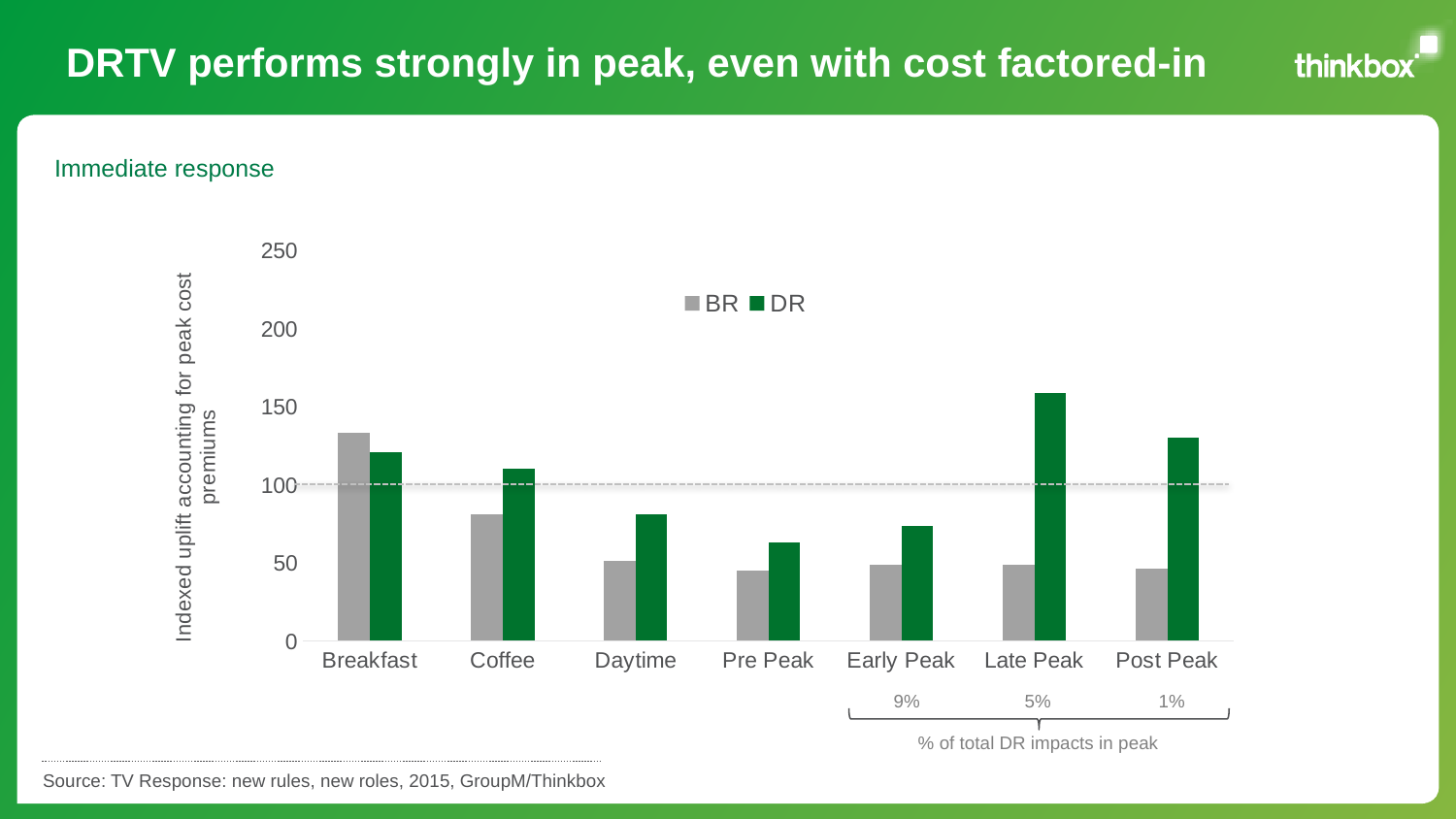
Which daypart has the lowest DR value? Pre Peak Which is larger for Breakfast, the BR value or the DR value? BR Is the DR value for Post Peak greater or less than 100? greater Which daypart has the highest DR value? Late Peak What percentage of total DR impacts in peak is shown for Early Peak? 9% Which daypart has the highest BR value? Breakfast What is the label of the vertical axis? Indexed uplift accounting for peak cost premiums How many series does the legend list? 2 How many dayparts (categories) are shown on the x axis? 7 Is the BR value for Daytime greater or less than 100? less Is the DR value for Late Peak greater or less than 150? greater What kind of chart is shown on the slide? bar chart